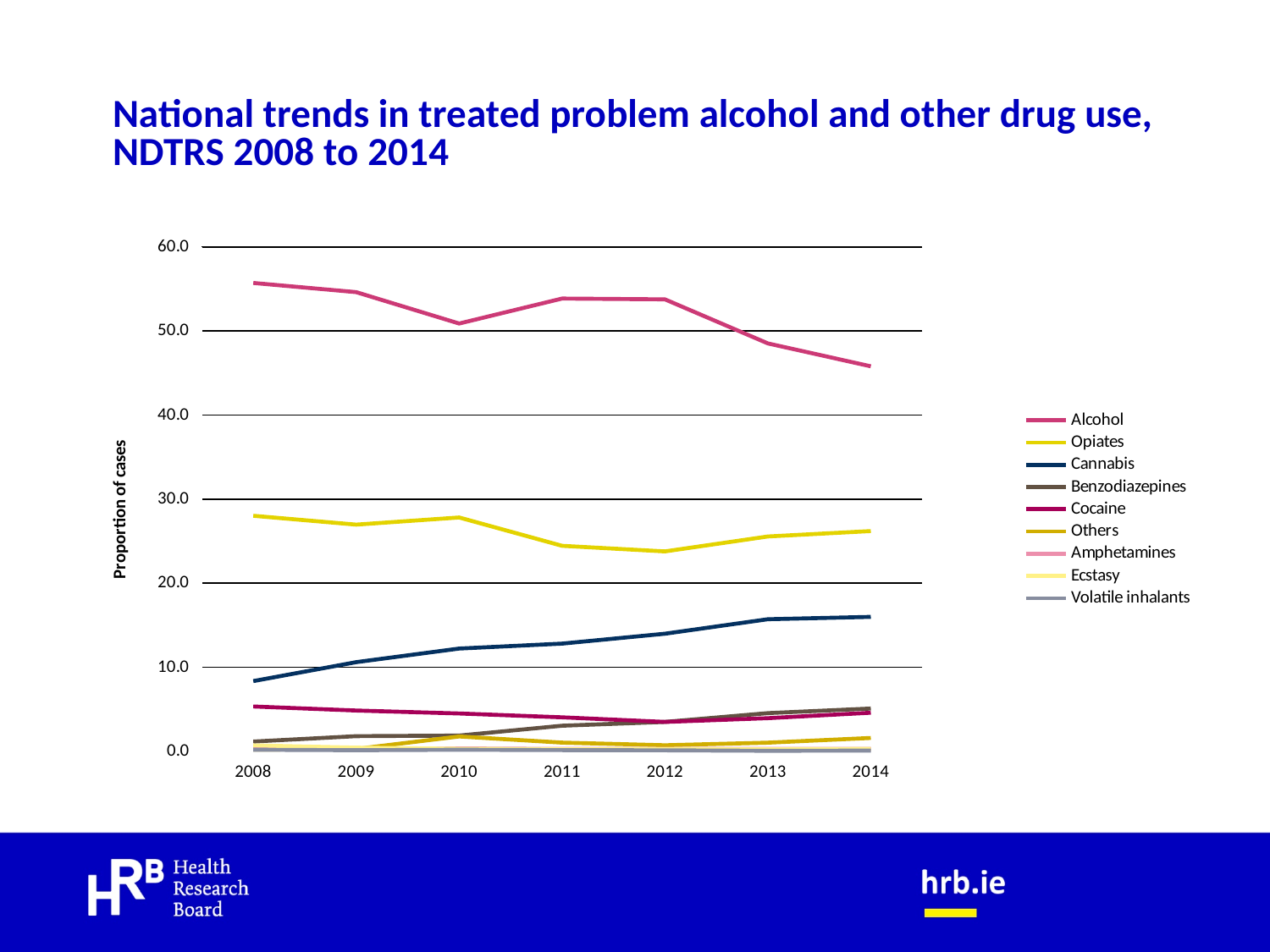
What is the label on the y axis? Proportion of cases In 2014, which is larger: Opiates or Cannabis? Opiates Does the Cannabis line rise or fall from 2008 to 2014? Rise Is the value for Opiates in 2008 greater or less than 30.0? less How many series does the legend list? 9 Is the value for Alcohol in 2008 greater or less than 50.0? greater Is the value for Cannabis in 2014 greater or less than 10.0? greater How many years are plotted along the x axis? 7 Does the Alcohol line rise or fall from 2008 to 2014? Fall Which series has the highest values across all years? Alcohol What kind of chart is shown on the slide? Line chart